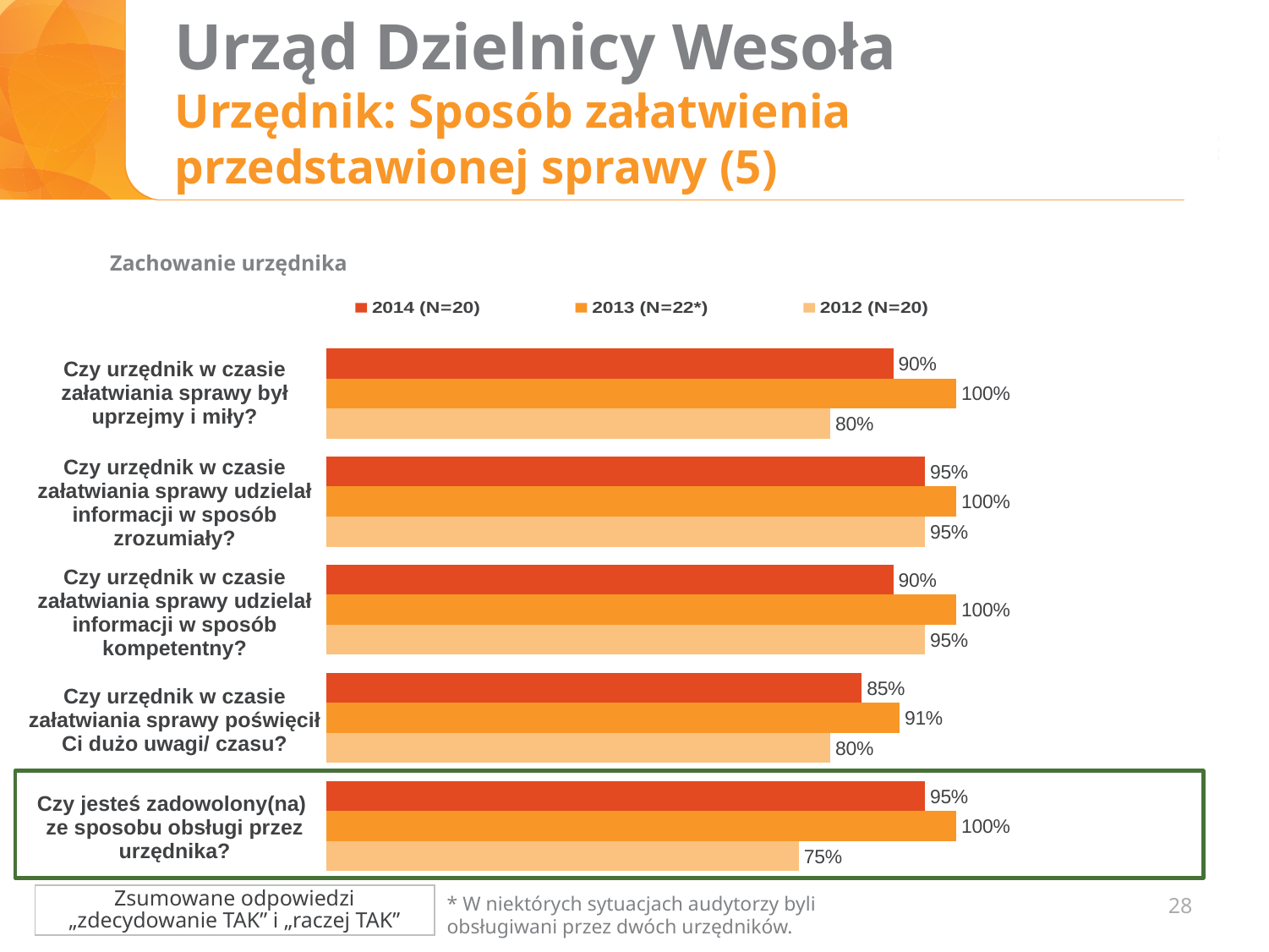
How many question categories are plotted in the chart? 5 What is the difference between the 2013 (N=22*) and 2012 (N=20) values for "Czy jesteś zadowolony(na) ze sposobu obsługi przez urzędnika?"? 25% How many series does the chart legend list? 3 What is the 2014 (N=20) value for "Czy urzędnik w czasie załatwiania sprawy był uprzejmy i miły?"? 90% What is the 2012 (N=20) value for "Czy jesteś zadowolony(na) ze sposobu obsługi przez urzędnika?"? 75% What is the difference between the 2014 (N=20) and 2013 (N=22*) values for "Czy urzędnik w czasie załatwiania sprawy poświęcił Ci dużo uwagi/ czasu?"? 6% Which category has the lowest 2014 (N=20) value? Czy urzędnik w czasie załatwiania sprawy poświęcił Ci dużo uwagi/ czasu? Which category has the lowest 2012 (N=20) value? Czy jesteś zadowolony(na) ze sposobu obsługi przez urzędnika? For "Czy urzędnik w czasie załatwiania sprawy był uprzejmy i miły?", which is larger: the 2014 (N=20) value or the 2012 (N=20) value? 2014 (N=20) What is the title shown above the chart? Zachowanie urzędnika What kind of chart is shown on the slide? bar chart What is the 2013 (N=22*) value for "Czy urzędnik w czasie załatwiania sprawy poświęcił Ci dużo uwagi/ czasu?"? 91%